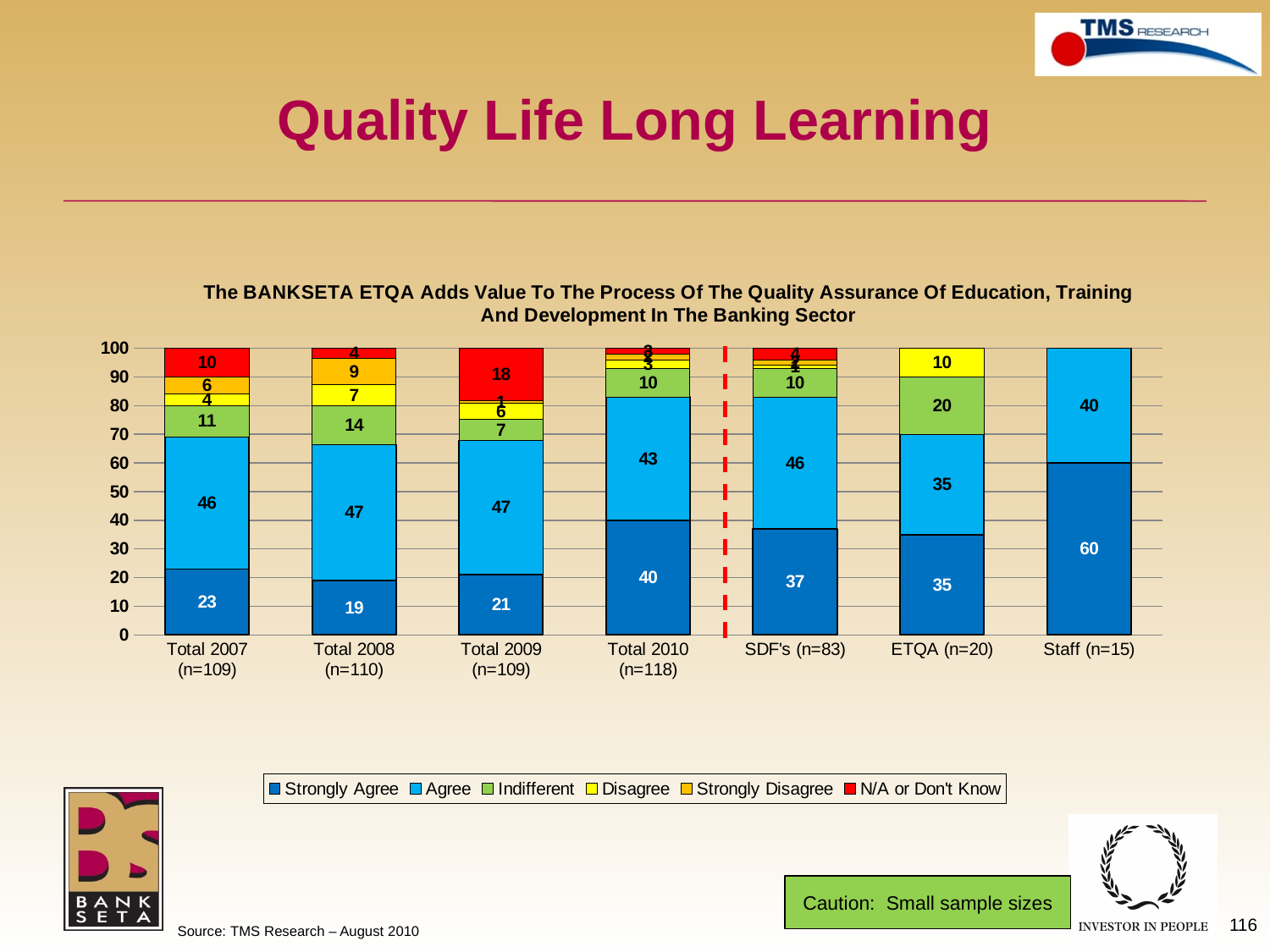
Which category has the highest Strongly Agree value? Staff (n=15) Which is larger, the Agree value for SDF's (n=83) or the Agree value for ETQA (n=20)? SDF's (n=83) What is the difference between the Strongly Agree values for Total 2010 (n=118) and Total 2009 (n=109)? 19 What is the title of the chart? The BANKSETA ETQA Adds Value To The Process Of The Quality Assurance Of Education, Training And Development In The Banking Sector Which category has the lowest Strongly Agree value? Total 2008 (n=110) What is the N/A or Don't Know value for Total 2009 (n=109)? 18 What is the Strongly Agree value for Staff (n=15)? 60 How many categories are shown along the x axis? 7 What is the Indifferent value for ETQA (n=20)? 20 What kind of chart is shown on the slide? stacked bar chart What is the Agree value for Total 2010 (n=118)? 43 How many series does the legend list? 6